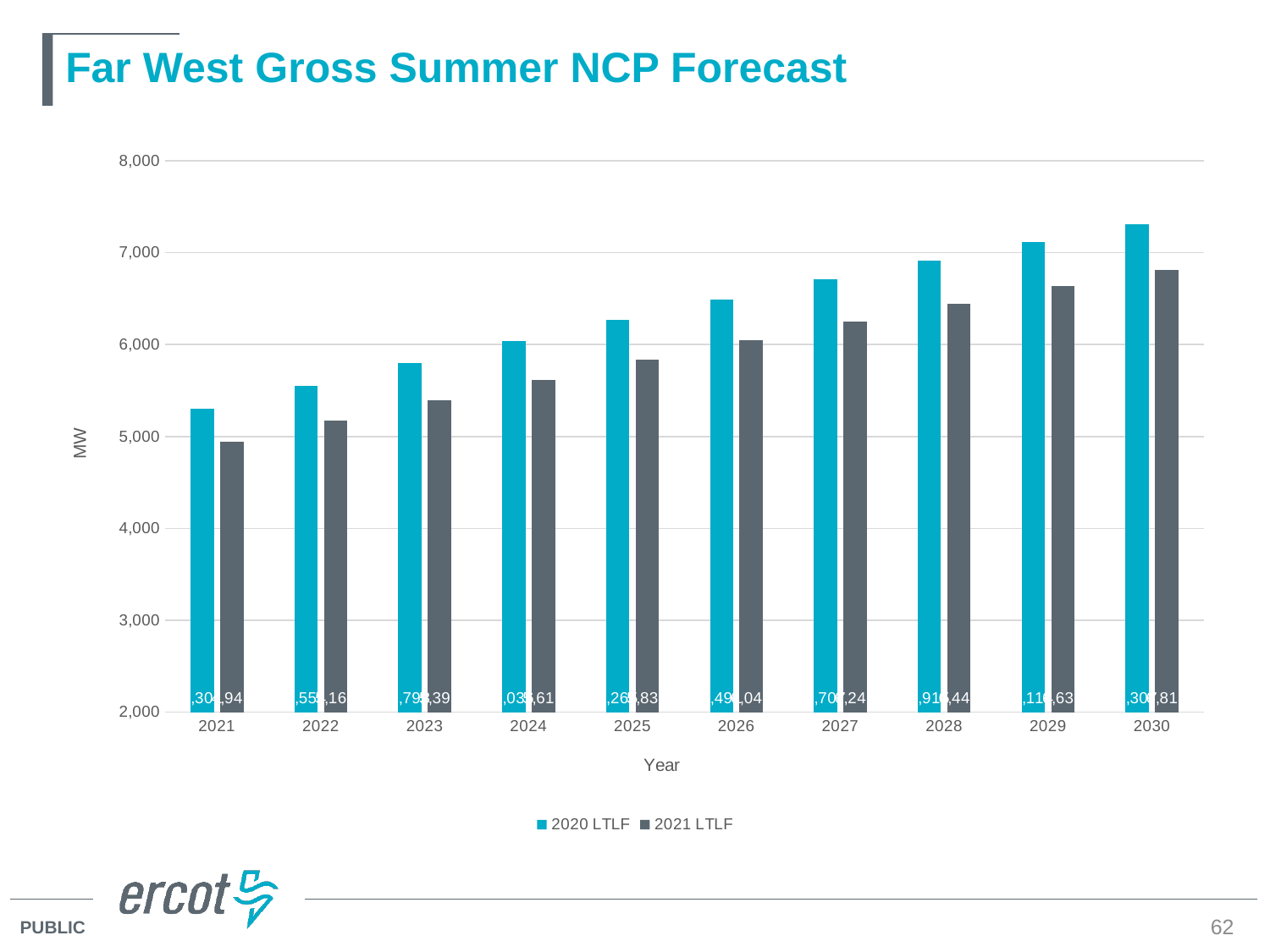
How many series does the legend list? 2 How many years are shown on the x axis? 10 Which year has the highest 2020 LTLF value? 2030 Do the 2021 LTLF values rise or fall from 2021 to 2030? rise Is the 2020 LTLF value for 2030 greater or less than 7,000? greater Is the 2021 LTLF value for 2030 greater or less than 7,000? less Is the 2020 LTLF value for 2025 greater or less than 6,000? greater What kind of chart is shown on the slide? bar chart What unit is shown on the y axis label? MW Which year has the lowest 2021 LTLF value? 2021 In 2021, which series has the larger value, 2020 LTLF or 2021 LTLF? 2020 LTLF